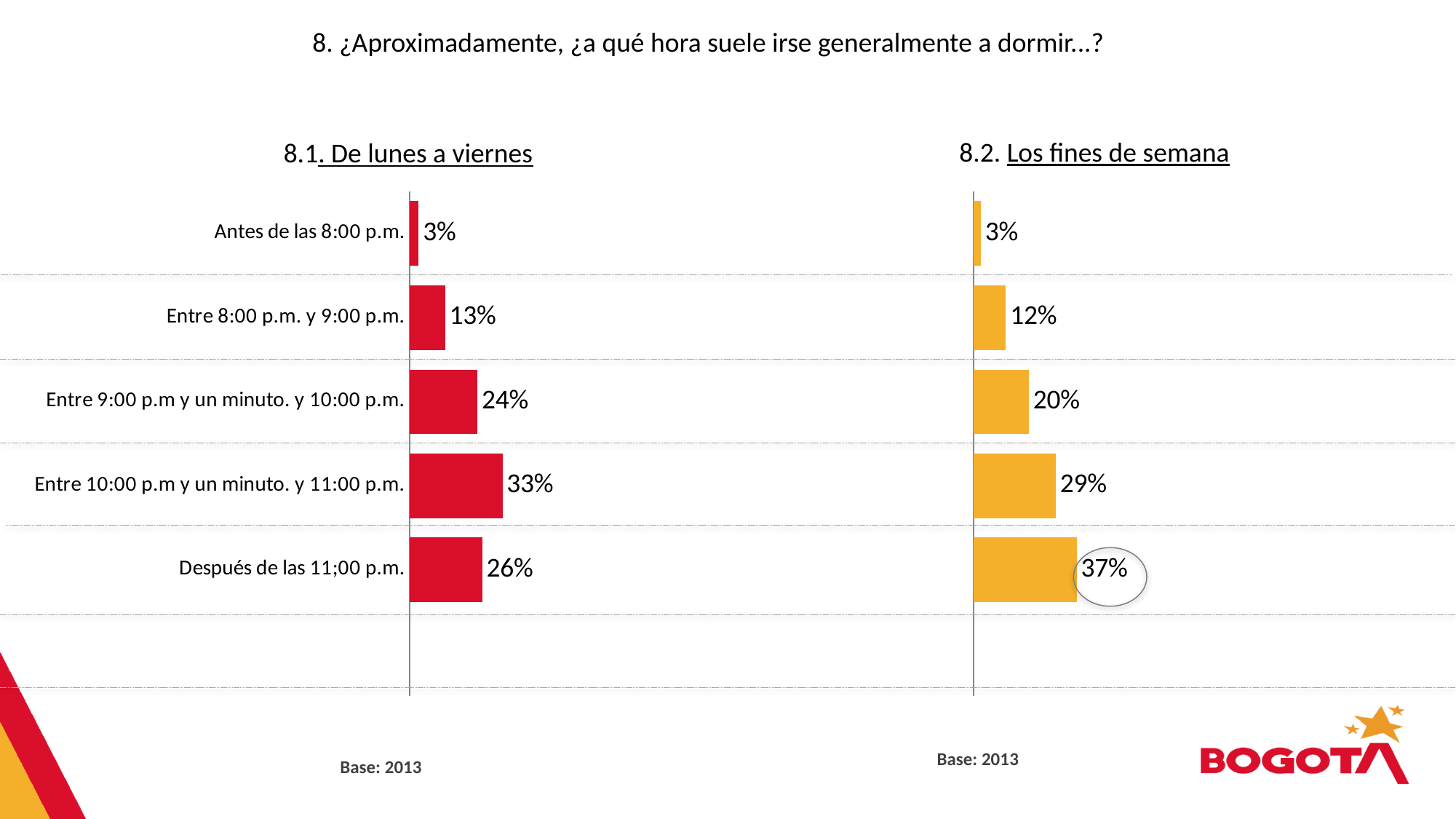
In the '8.2. Los fines de semana' chart, what is the difference between 'Después de las 11;00 p.m.' and 'Entre 10:00 p.m y un minuto. y 11:00 p.m.'? 8% In the '8.1. De lunes a viernes' chart, what is the difference between 'Entre 9:00 p.m y un minuto. y 10:00 p.m.' and 'Entre 8:00 p.m. y 9:00 p.m.'? 11% In the '8.2. Los fines de semana' chart, what is the value for 'Después de las 11;00 p.m.'? 37% In the '8.1. De lunes a viernes' chart, which category has the lowest value? Antes de las 8:00 p.m. Which is larger: the value for 'Entre 9:00 p.m y un minuto. y 10:00 p.m.' in the '8.1. De lunes a viernes' chart or in the '8.2. Los fines de semana' chart? 8.1. De lunes a viernes In the '8.2. Los fines de semana' chart, what is the value for 'Entre 8:00 p.m. y 9:00 p.m.'? 12% In the '8.1. De lunes a viernes' chart, which category has the highest value? Entre 10:00 p.m y un minuto. y 11:00 p.m. How many categories does the '8.1. De lunes a viernes' chart show? 5 In the '8.2. Los fines de semana' chart, which category has the highest value? Después de las 11;00 p.m. In the '8.1. De lunes a viernes' chart, what is the value for 'Entre 10:00 p.m y un minuto. y 11:00 p.m.'? 33% What colour are the bars in the '8.1. De lunes a viernes' chart? Red What kind of chart is the '8.2. Los fines de semana' chart? Bar chart